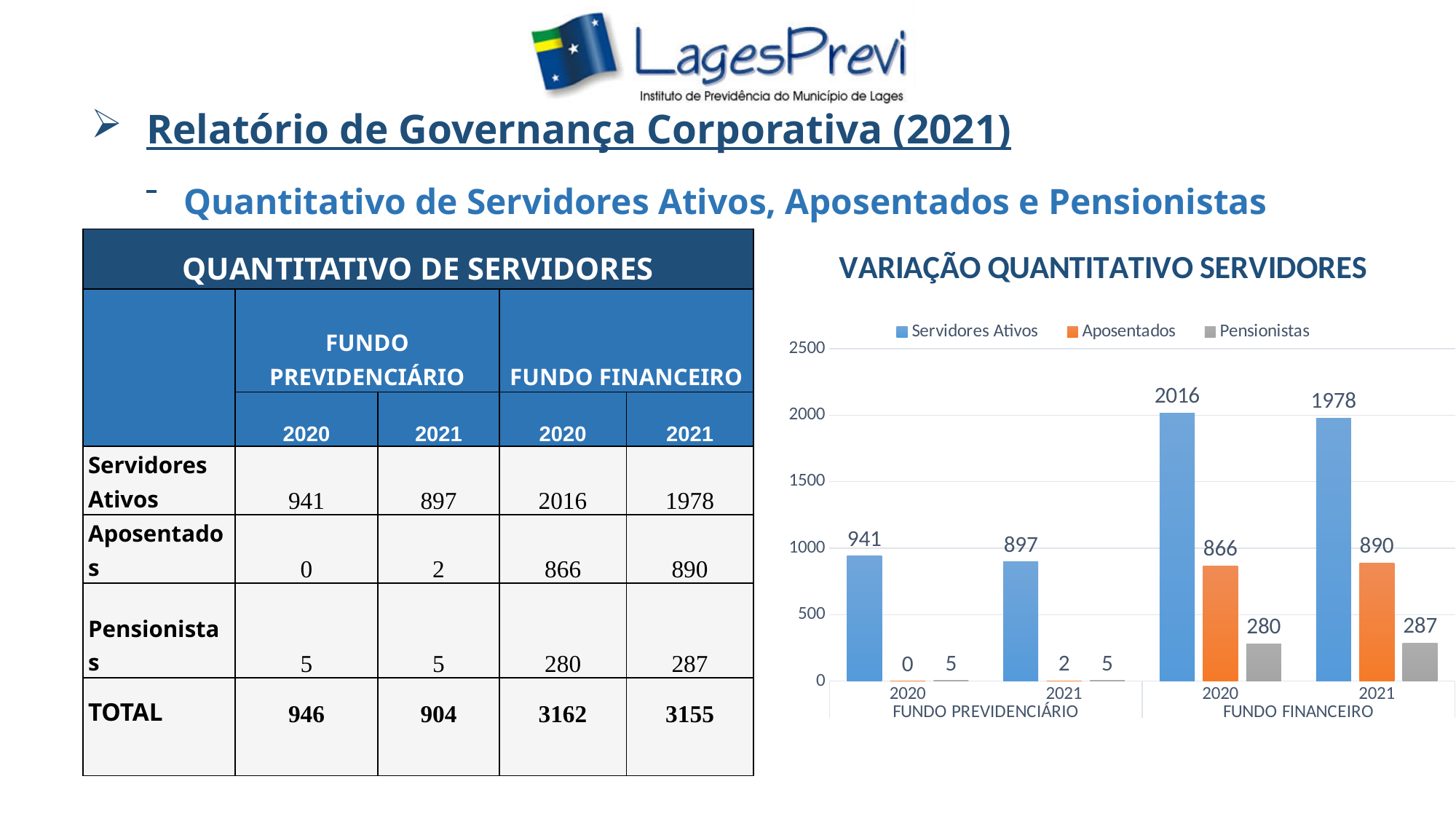
What is the difference between Servidores Ativos in 2020 and 2021 under FUNDO FINANCEIRO? 38 How many series does the chart legend list? 3 Which is larger: Aposentados in 2020 or Aposentados in 2021 under FUNDO FINANCEIRO? Aposentados in 2021 What is the value for Servidores Ativos in 2020 under FUNDO FINANCEIRO in the chart? 2016 What is the value for Servidores Ativos in 2021 under FUNDO PREVIDENCIÁRIO in the chart? 897 Is the value for Servidores Ativos in 2021 under FUNDO FINANCEIRO greater or less than 1500? greater What is the difference between Pensionistas in 2021 and 2020 under FUNDO FINANCEIRO? 7 What is the value for Pensionistas in 2020 under FUNDO PREVIDENCIÁRIO in the chart? 5 What is the title of the chart? VARIAÇÃO QUANTITATIVO SERVIDORES What is the value for Aposentados in 2021 under FUNDO FINANCEIRO in the chart? 890 Which group has the highest value in the chart? Servidores Ativos, 2020, FUNDO FINANCEIRO What kind of chart is shown on the slide? bar chart